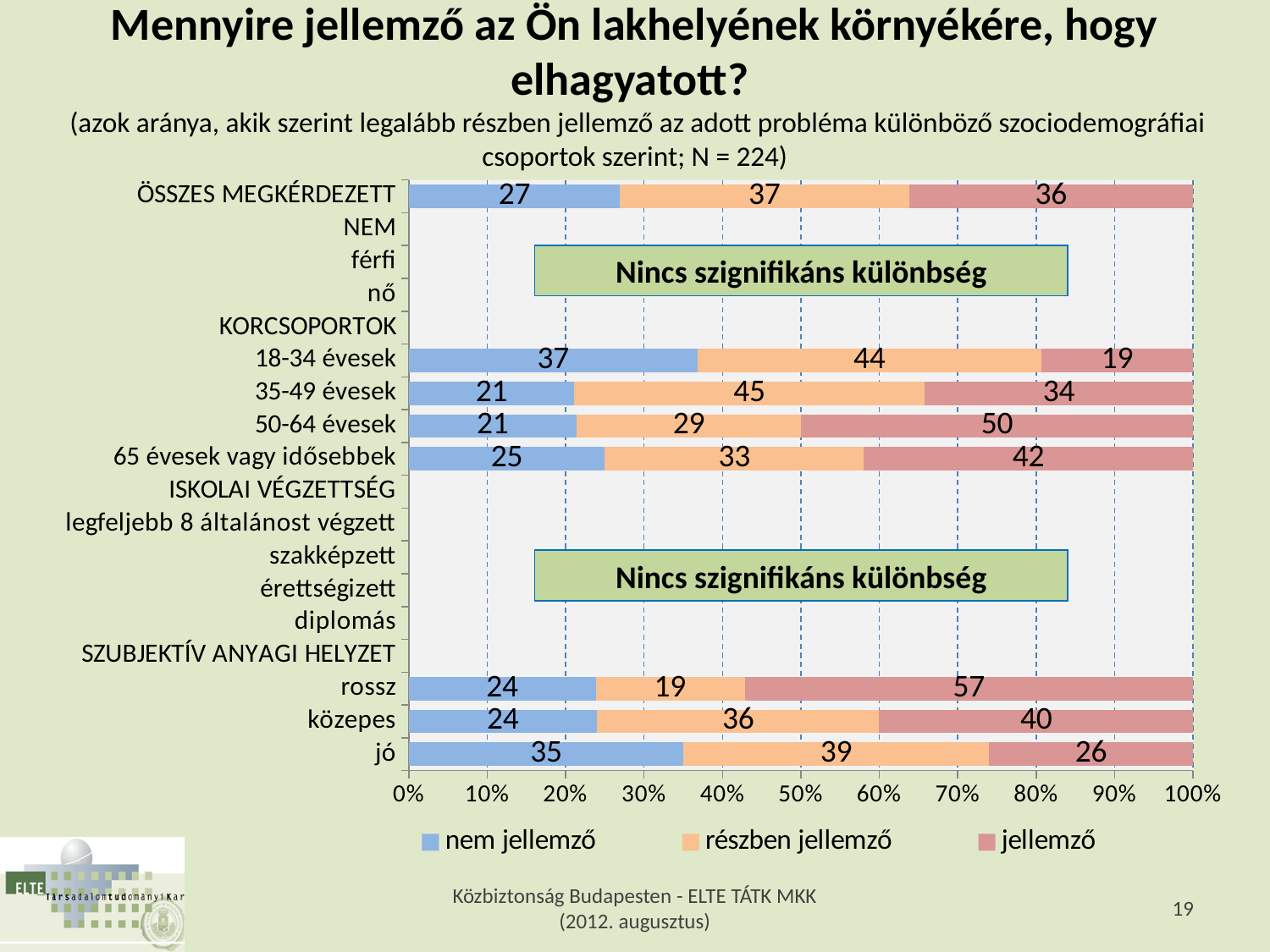
Which is larger: the "részben jellemző" value for "35-49 évesek" or for "50-64 évesek"? 35-49 évesek What is the value of "nem jellemző" for "18-34 évesek"? 37 What is the value of "részben jellemző" for "ÖSSZES MEGKÉRDEZETT"? 37 Which legend entry is shown in red? jellemző Which category has the lowest "jellemző" value among all plotted bars? 18-34 évesek Which age group has the highest "jellemző" value? 50-64 évesek What type of chart is shown on the slide? stacked bar chart How many series does the legend list? 3 What is the total of the stacked bar for "közepes"? 100 What is the value of "jellemző" for the "rossz" category? 57 What text appears in the green boxes placed over the NEM and ISKOLAI VÉGZETTSÉG sections? Nincs szignifikáns különbség What is the difference between the "jellemző" values for "rossz" and "jó"? 31